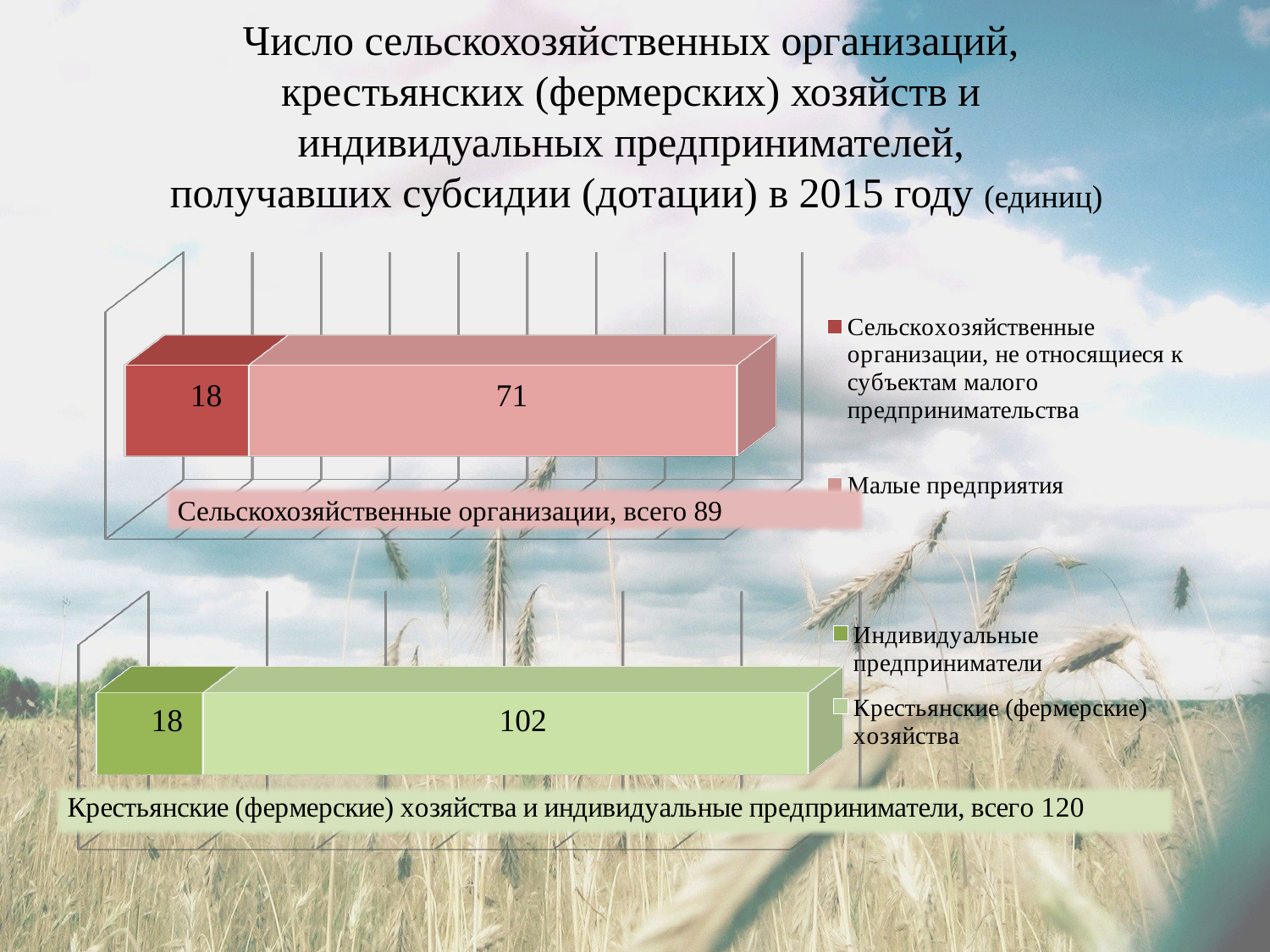
On the bottom chart, what is the difference between the value for Крестьянские (фермерские) хозяйства and the value for Индивидуальные предприниматели? 84 On the bottom chart, which is larger: Индивидуальные предприниматели or Крестьянские (фермерские) хозяйства? Крестьянские (фермерские) хозяйства On the bottom chart, what is the total of the stacked bar (Крестьянские (фермерские) хозяйства и индивидуальные предприниматели, всего)? 120 On the bottom chart, what is the value for Индивидуальные предприниматели? 18 On the top chart, what is the value for Сельскохозяйственные организации, не относящиеся к субъектам малого предпринимательства? 18 On the top chart, what is the value for Малые предприятия? 71 How many series does the legend of the bottom chart list? 2 On the bottom chart, what is the value for Крестьянские (фермерские) хозяйства? 102 On the top chart, which series has the larger value? Малые предприятия What kind of chart is the top chart? Stacked bar chart On the top chart, what is the total of the stacked bar (Сельскохозяйственные организации, всего)? 89 On the top chart, what is the difference between the value for Малые предприятия and the value for Сельскохозяйственные организации, не относящиеся к субъектам малого предпринимательства? 53